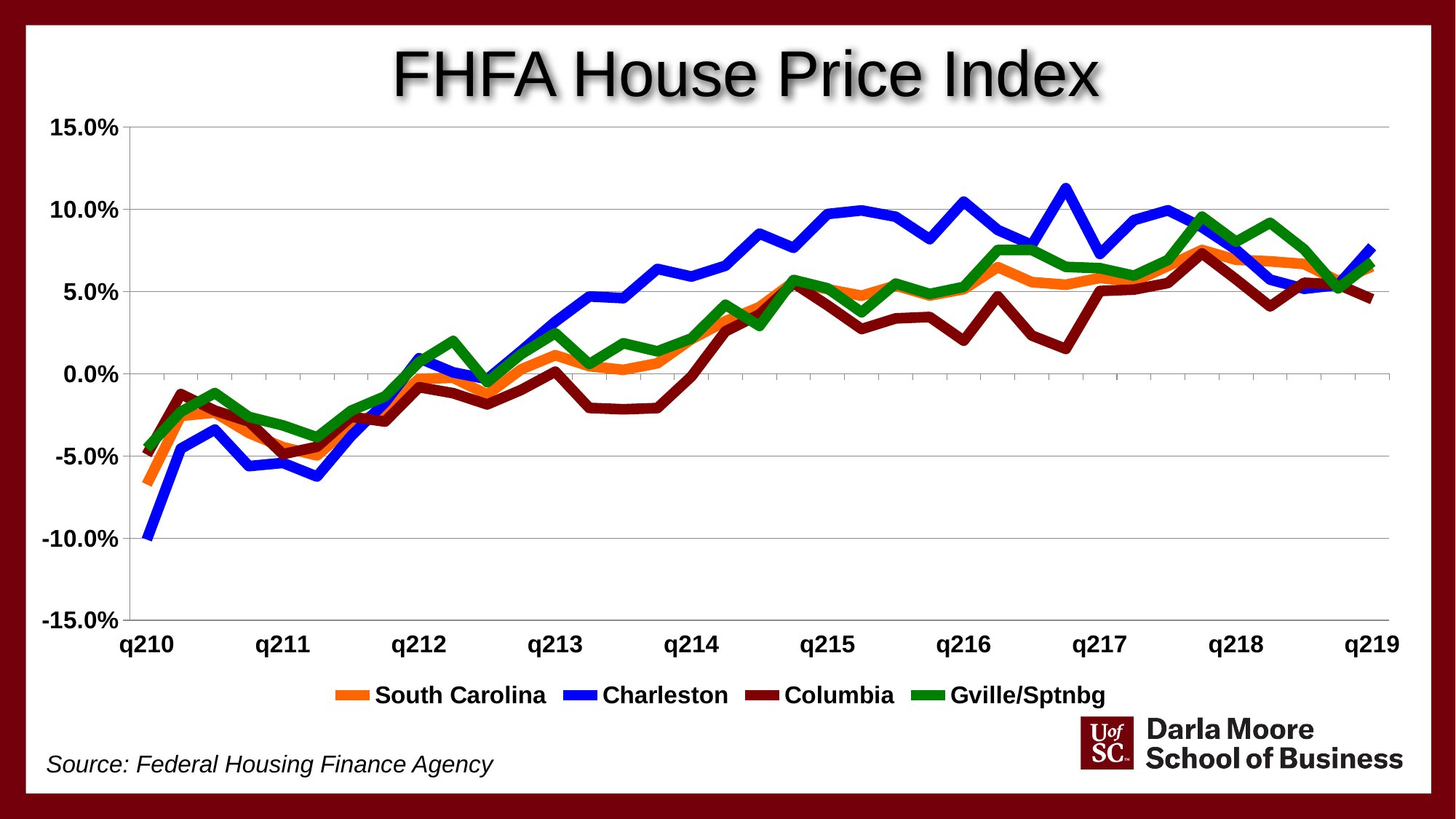
Is the value for South Carolina at q210 greater or less than -5.0%? less How many year labels are shown along the x axis? 10 Is the value for Charleston at q215 greater or less than 5.0%? greater Which series has the highest value at q215? Charleston Is the value for Columbia at q216 greater or less than 0.0%? greater What is the title of the chart? FHFA House Price Index Which series is drawn in green in the chart? Gville/Sptnbg What kind of chart is shown on the slide? line chart Does the South Carolina line generally rise or fall from q210 to q219? rise How many series does the legend list? 4 Which series has the lowest value at q210? Charleston